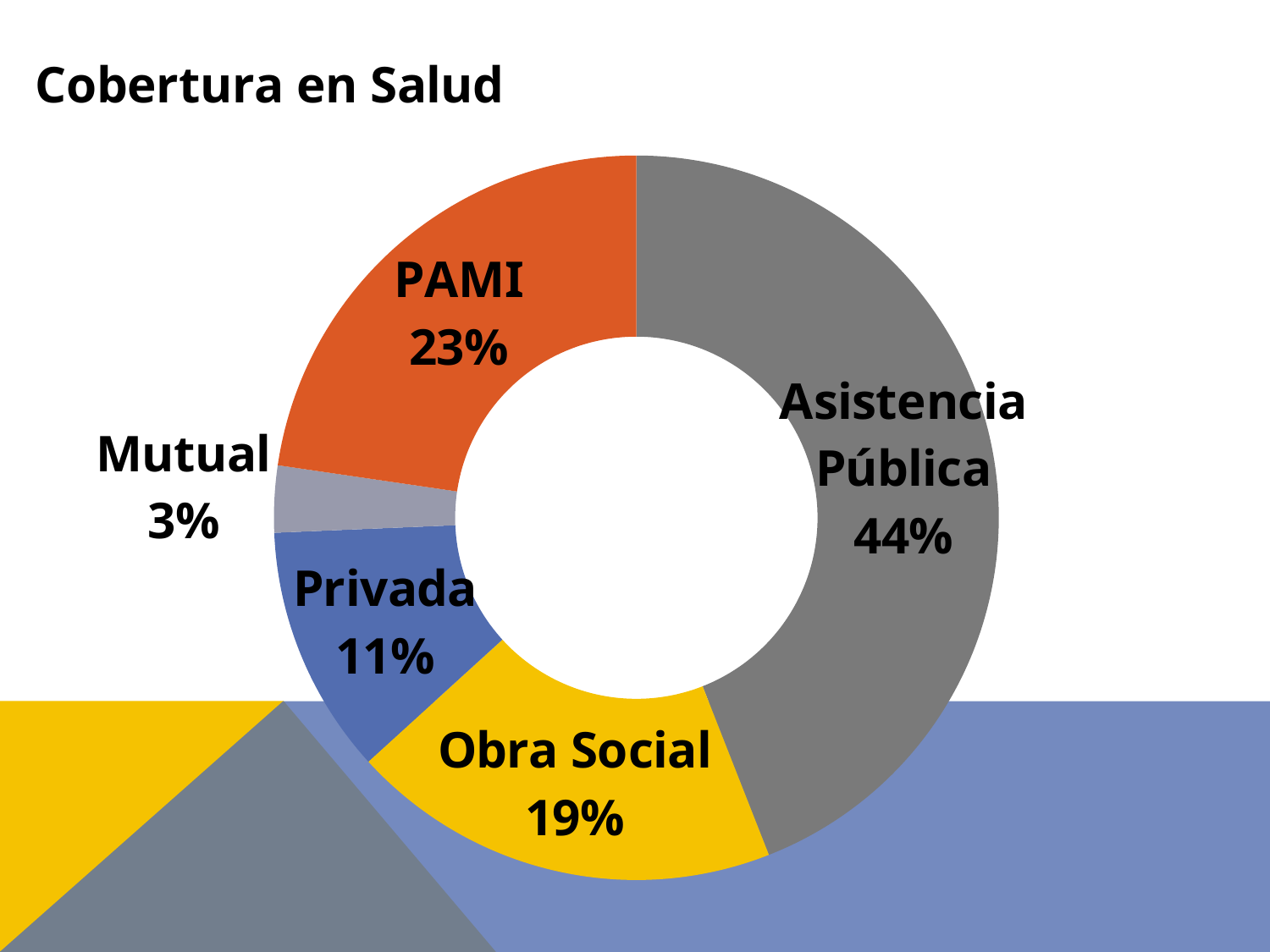
What share of the chart does Asistencia Pública represent? 44% What is the value shown for PAMI? 23% What percentage is shown for Obra Social? 19% What is the difference between the shares of Asistencia Pública and PAMI? 21% Which category has the smallest share? Mutual Which category has the largest share? Asistencia Pública What is the value for Mutual? 3% What kind of chart is shown on the slide? Doughnut (pie) chart What is the title of the chart? Cobertura en Salud How many categories are shown in the chart? 5 Which is larger, Obra Social or Privada? Obra Social What is the value for Privada? 11%